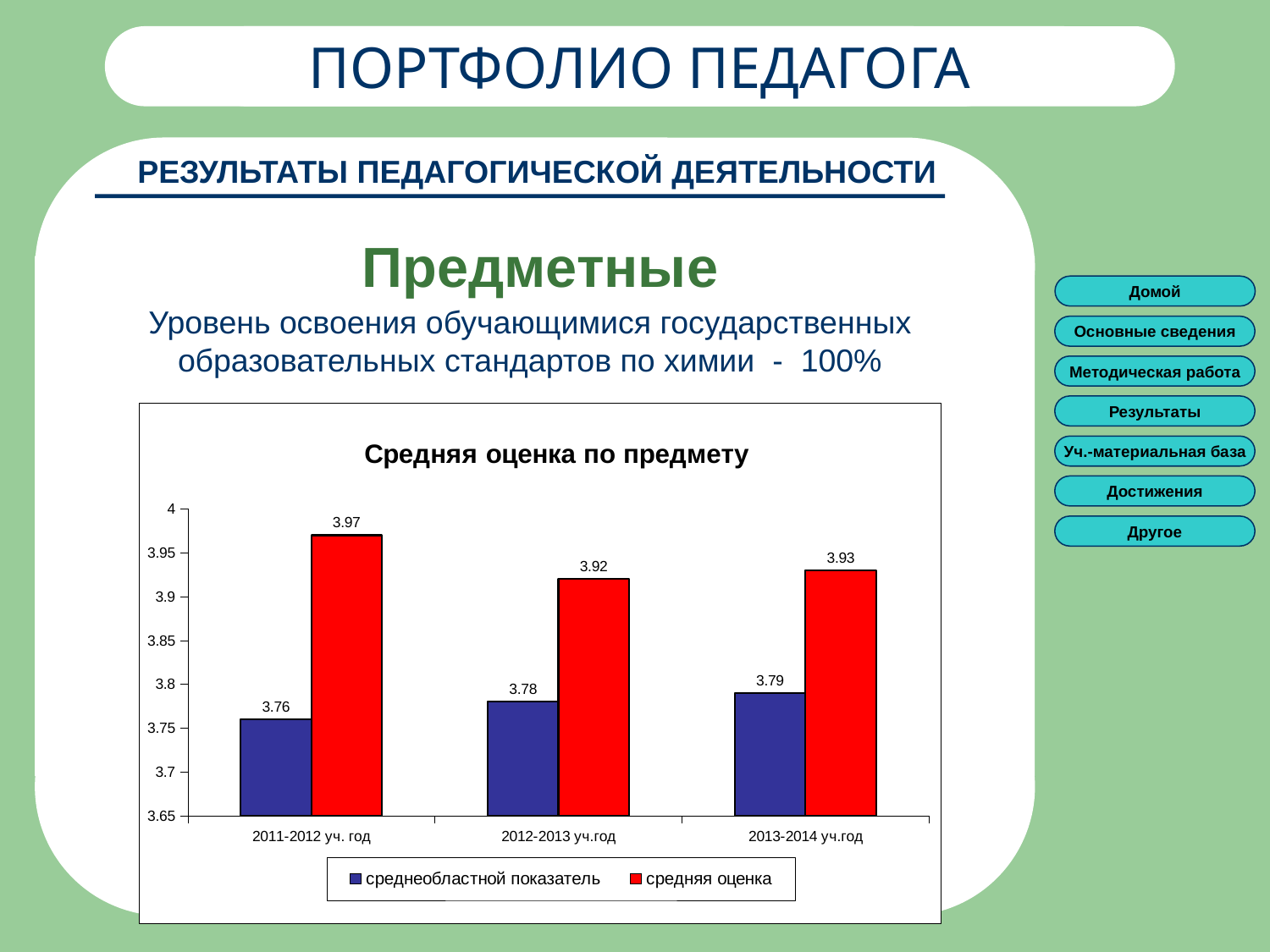
How many academic years are shown on the x axis? 3 What is the difference between 'средняя оценка' and 'среднеобластной показатель' for 2011-2012 уч. год? 0.21 Which is larger for 2013-2014 уч.год: 'средняя оценка' or 'среднеобластной показатель'? средняя оценка In which year is 'средняя оценка' the highest? 2011-2012 уч. год In which year is 'среднеобластной показатель' the lowest? 2011-2012 уч. год What is the value of 'средняя оценка' for 2012-2013 уч.год? 3.92 How many series does the legend list? 2 What is the value of 'среднеобластной показатель' for 2013-2014 уч.год? 3.79 Is the value of 'среднеобластной показатель' for 2012-2013 уч.год greater or less than 3.8? less What is the title of the chart? Средняя оценка по предмету What is the value of 'средняя оценка' for 2011-2012 уч. год? 3.97 What kind of chart is shown? bar chart